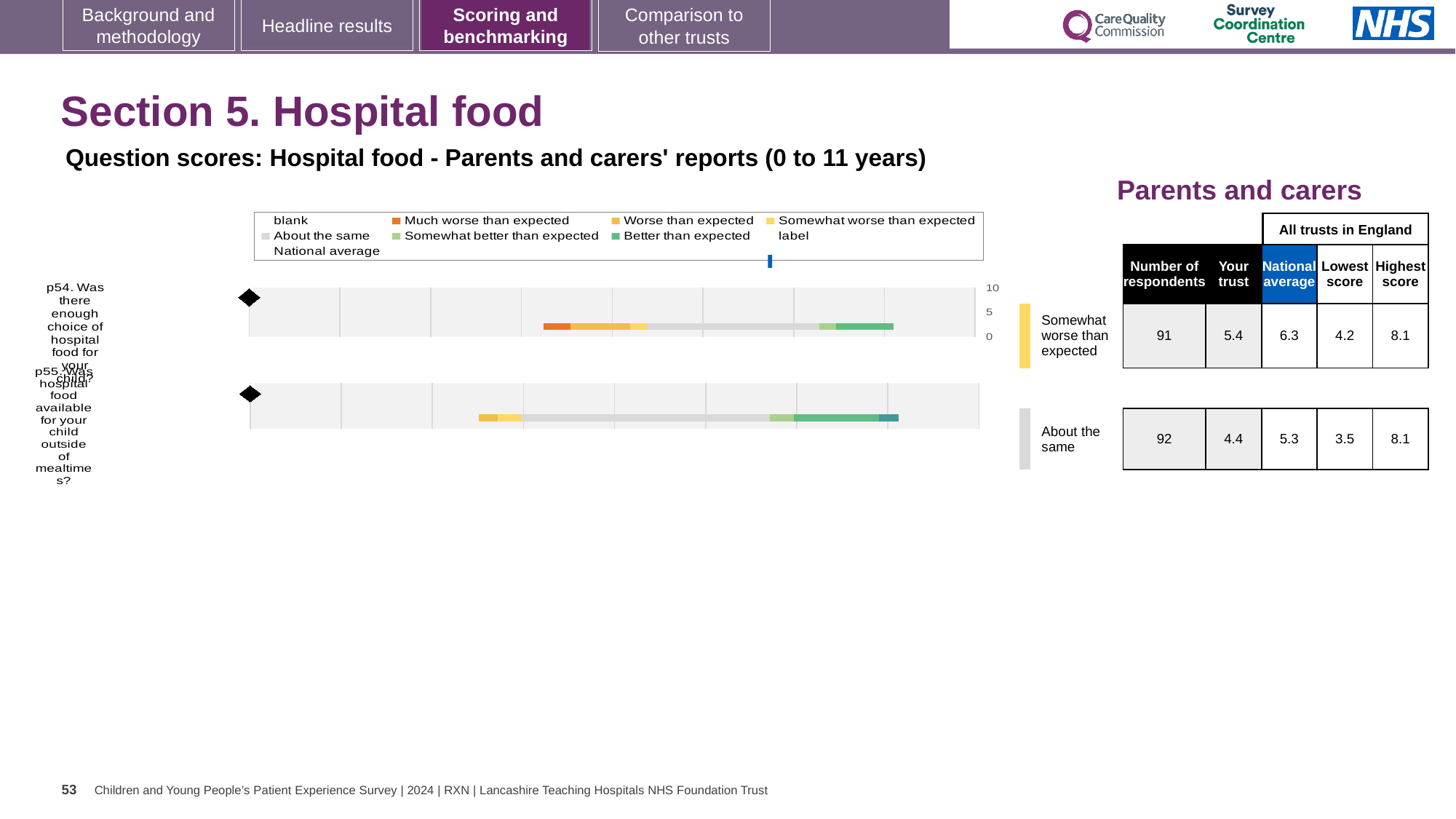
How many questions (categories) are plotted in the hospital food chart? 2 According to the table, how many respondents answered p54 (enough choice of hospital food)? 91 What is the highest score among all trusts in England for p54? 8.1 According to the table, what is the lowest score among all trusts in England for p55? 3.5 What is the difference between the national average and the 'Your trust' score for p54? 0.9 According to the table, what is the national average for p54 (enough choice of hospital food)? 6.3 What is the highest value shown on the chart's axis? 10 Which question has the higher 'Your trust' score, p54 or p55? p54 What kind of chart is used to show the question scores for hospital food? bar chart What benchmark category is p55 (hospital food outside of mealtimes) assigned to? About the same According to the table, what is the 'Your trust' score for p55 (hospital food available outside of mealtimes)? 4.4 What colour does the legend use for 'Much worse than expected'? orange